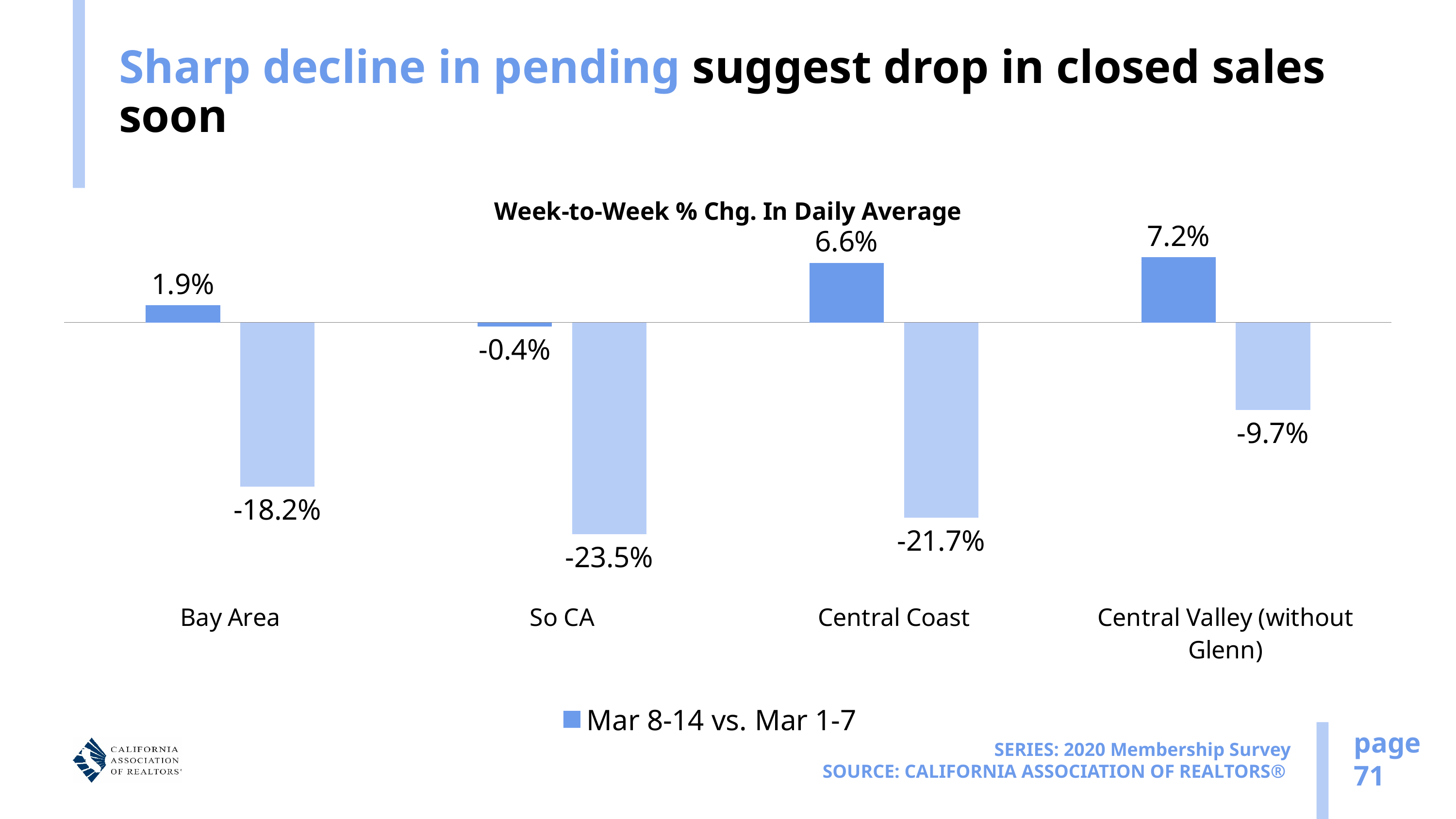
What is the value of the lighter blue bar for Central Valley (without Glenn)? -9.7% What kind of chart is shown on the slide? Bar chart How many regions are shown on the x axis? 4 What is the value of the lighter blue bar for So CA? -23.5% Which region has the highest value on the chart? Central Valley (without Glenn) (7.2%) What is the title of the chart? Week-to-Week % Chg. In Daily Average What is the difference between the darker blue bar (1.9%) and the lighter blue bar (-18.2%) for Bay Area? 20.1 percentage points Which bar shows the lowest value on the chart? The lighter blue bar for So CA (-23.5%) What is the value of the darker blue bar for Central Coast? 6.6% Which is larger: the lighter blue bar for Bay Area or the lighter blue bar for Central Coast? Bay Area (-18.2%) What is the value of the darker blue bar for Bay Area? 1.9% How many entries does the legend list? 1